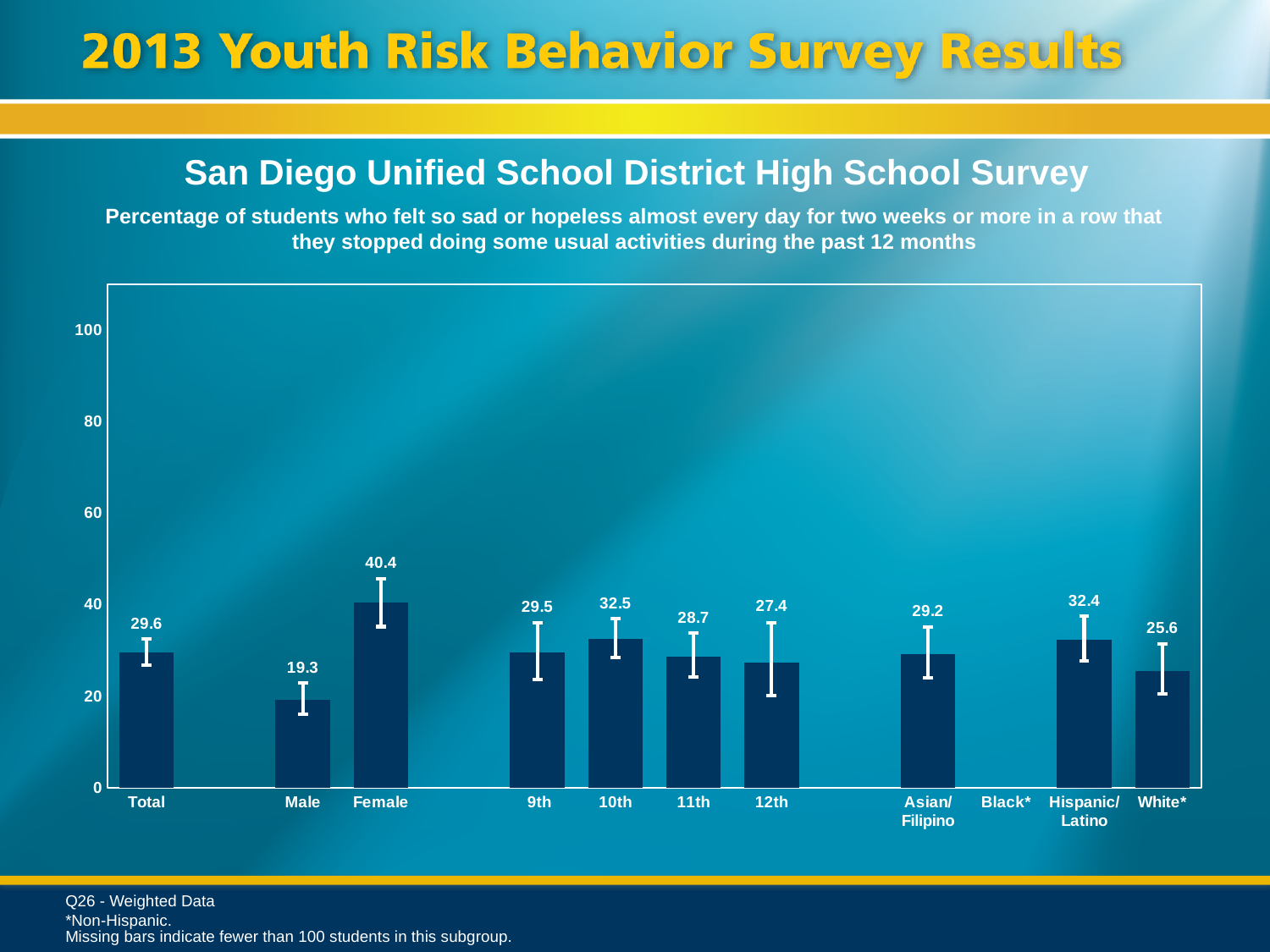
What is the value for Male? 19.3 What is the value for Female? 40.4 Which is larger, the value for 9th grade or the value for 12th grade? 9th What kind of chart is shown? bar chart What is the difference between the Female and Male values? 21.1 What is the value for 10th grade? 32.5 Is the value for Hispanic/Latino greater or less than 20? greater Which category has the highest value? Female Do the values fall from 10th grade to 12th grade? Yes, they fall Which category has the lowest value among those with bars? Male Which category has no bar shown? Black* What is the value for Total? 29.6